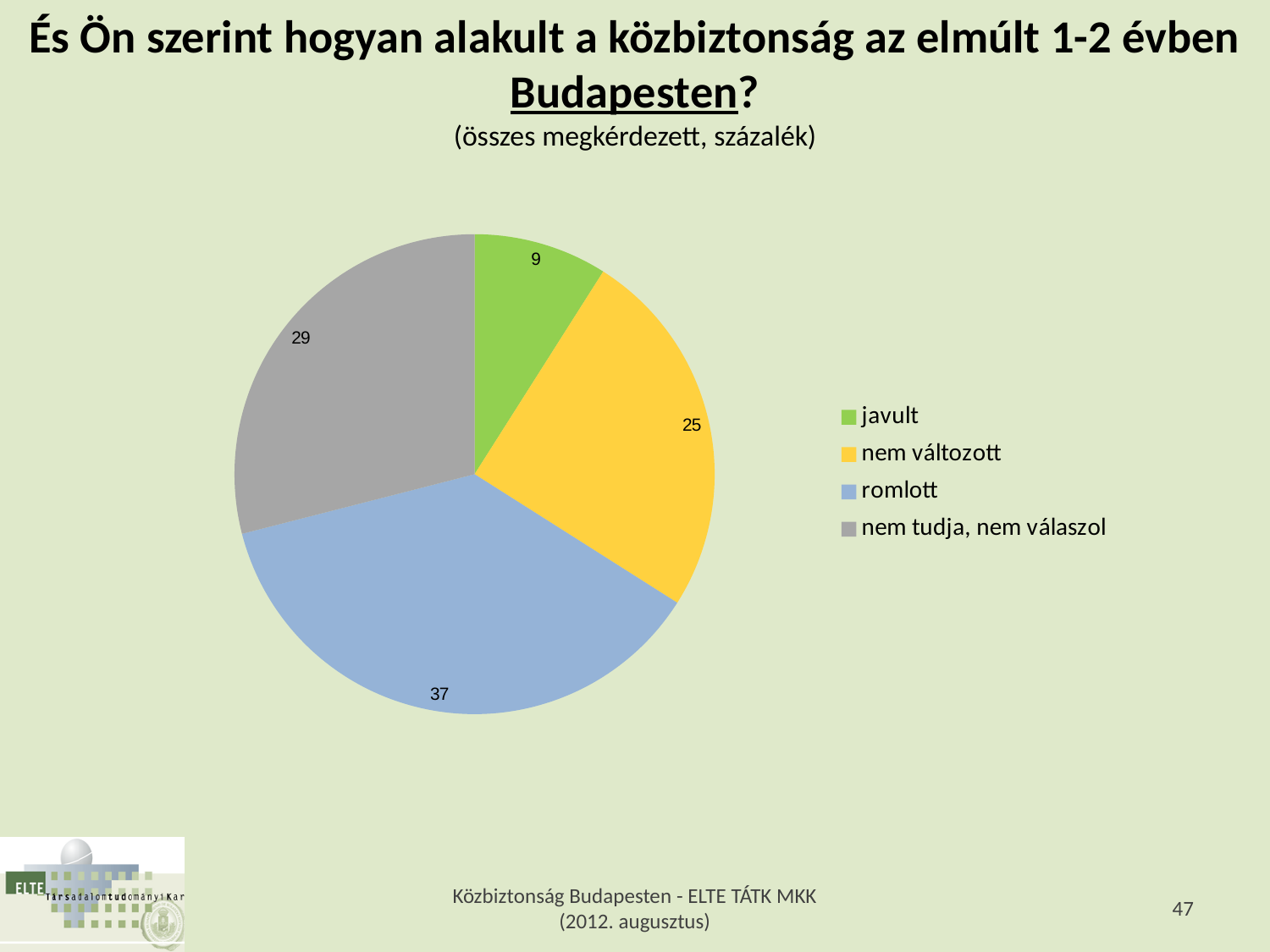
What value is shown for the "javult" slice? 9 What value is shown for the "nem tudja, nem válaszol" slice? 29 Which category has the smallest slice of the pie? javult What colour is the "romlott" slice? blue What value is shown for the "romlott" slice? 37 Which category has the largest slice of the pie? romlott How many slices does the pie chart have? 4 What is the difference between the values for "romlott" and "nem változott"? 12 What kind of chart is shown on the slide? pie chart Which is larger, the value for "nem tudja, nem válaszol" or the value for "nem változott"? nem tudja, nem válaszol What value is shown for the "nem változott" slice? 25 What is the total of the values for "javult" and "nem változott"? 34